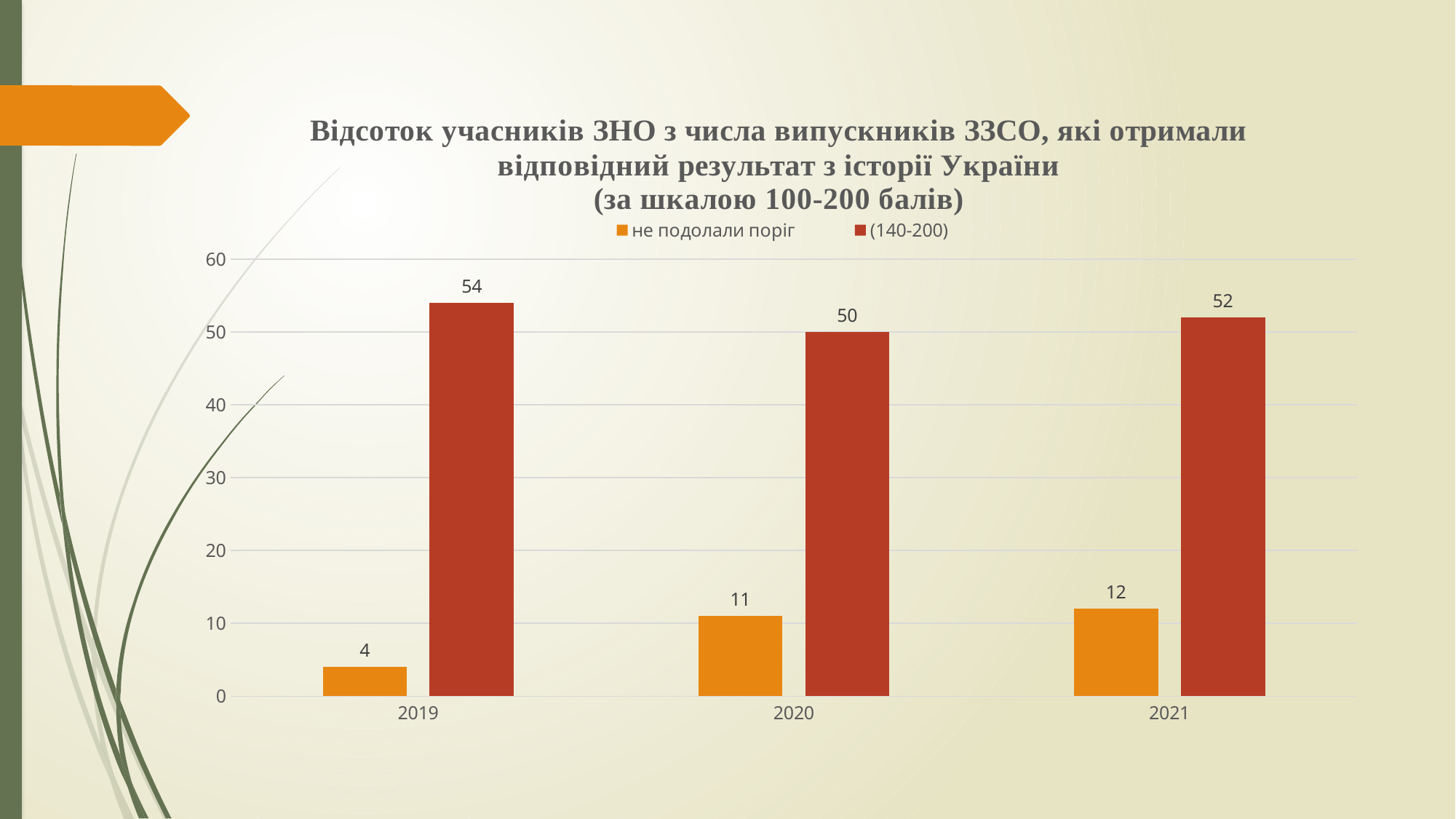
How many series does the legend list? 2 Does the "не подолали поріг" series rise or fall from 2019 to 2021? rise What is the value for "не подолали поріг" in 2021? 12 What is the value for "не подолали поріг" in 2019? 4 Is the value for "(140-200)" in 2019 greater or less than 50? greater In which year is the "(140-200)" value highest? 2019 In which year is the "не подолали поріг" value lowest? 2019 What is the value for "(140-200)" in 2020? 50 How many years are shown on the x axis? 3 What kind of chart is shown on the slide? bar chart Which is larger: the "(140-200)" value in 2020 or in 2021? 2021 What is the difference between the "(140-200)" value and the "не подолали поріг" value in 2021? 40